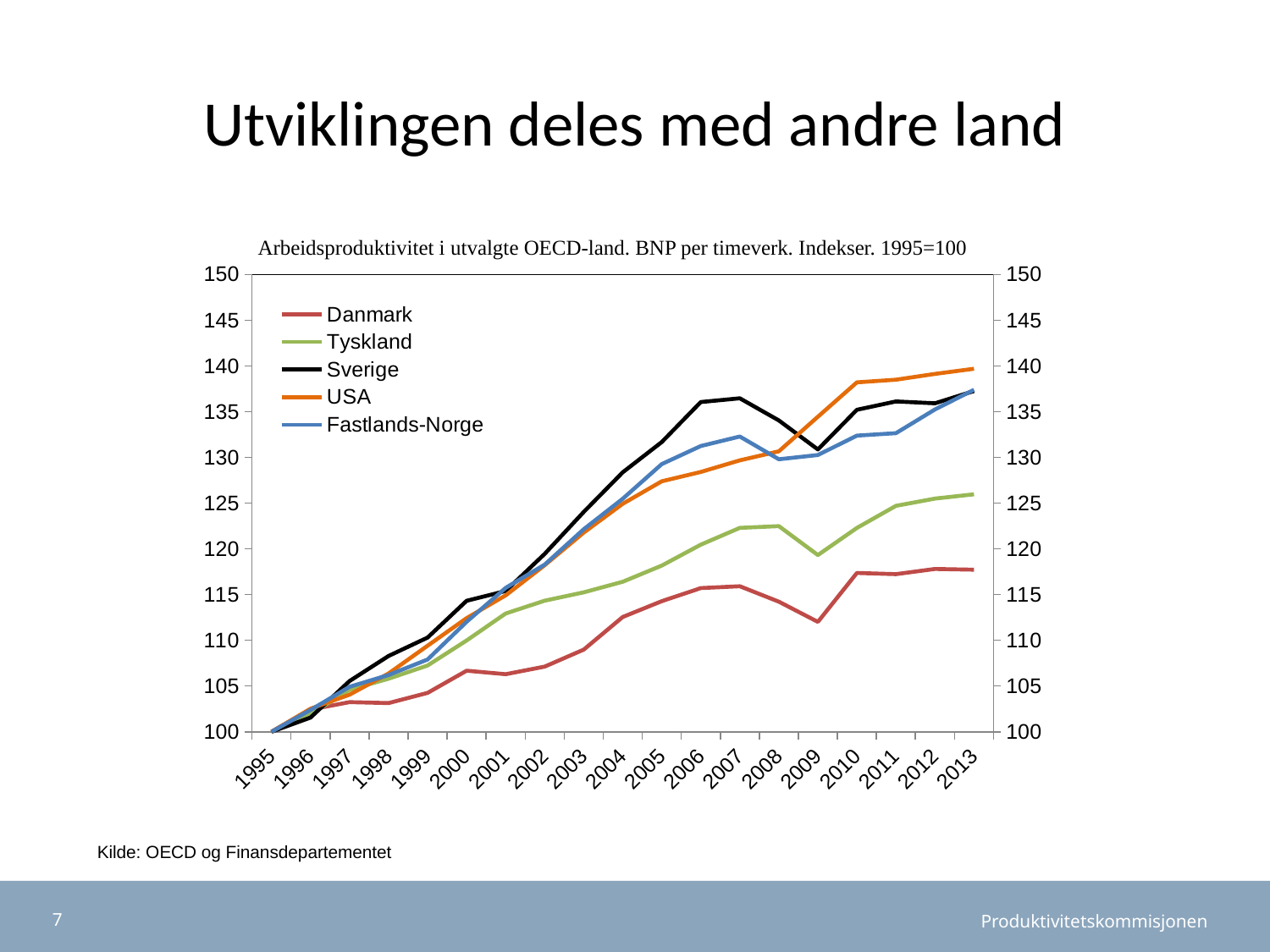
Which country has the lowest index value in 2013? Danmark Is the value for Danmark in 2013 greater or less than 120? less What kind of chart is shown on the slide? line chart How many series does the legend list? 5 What is the index value for all countries in 1995? 100 Which series is drawn in black? Sverige How many years are shown along the x axis? 19 Does the Danmark line generally rise or fall from 1995 to 2013? rise Is the value for USA in 2013 greater or less than 135? greater Which country has the highest index value in 2013? USA Is the value for Sverige in 2007 greater or less than 135? greater Which is higher in 2013, Tyskland or Danmark? Tyskland